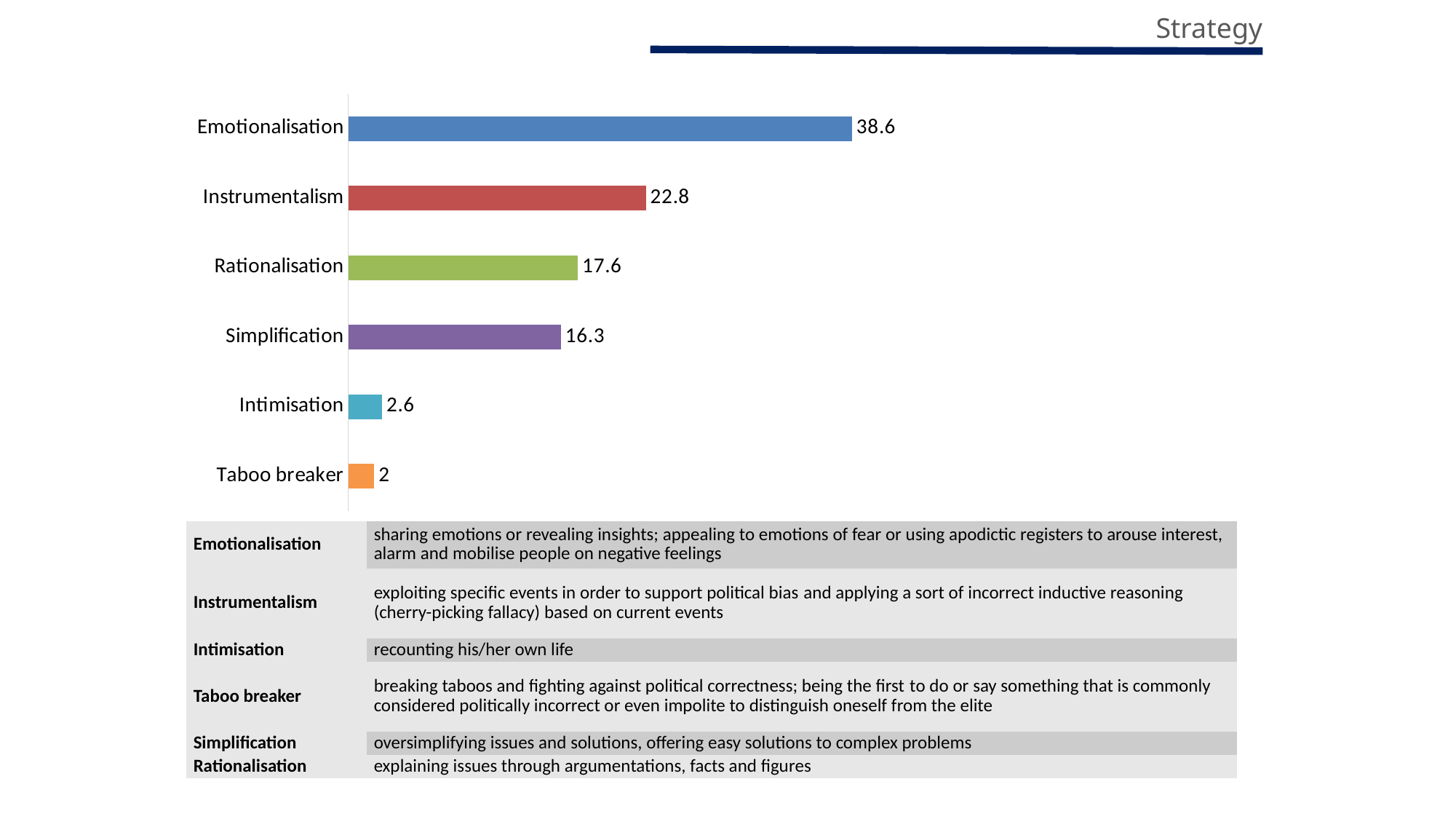
How many categories are shown in the chart? 6 Which category has the highest value? Emotionalisation What is the difference between the values for Rationalisation and Simplification? 1.3 Which category has the lowest value? Taboo breaker What is the value for Taboo breaker? 2 What is the value for Emotionalisation? 38.6 What kind of chart is shown on the slide? Bar chart What is the difference between the values for Emotionalisation and Instrumentalism? 15.8 What is the value for Simplification? 16.3 What is the value for Instrumentalism? 22.8 What colour is the bar for Rationalisation? Green Which is larger, the value for Intimisation or the value for Taboo breaker? Intimisation